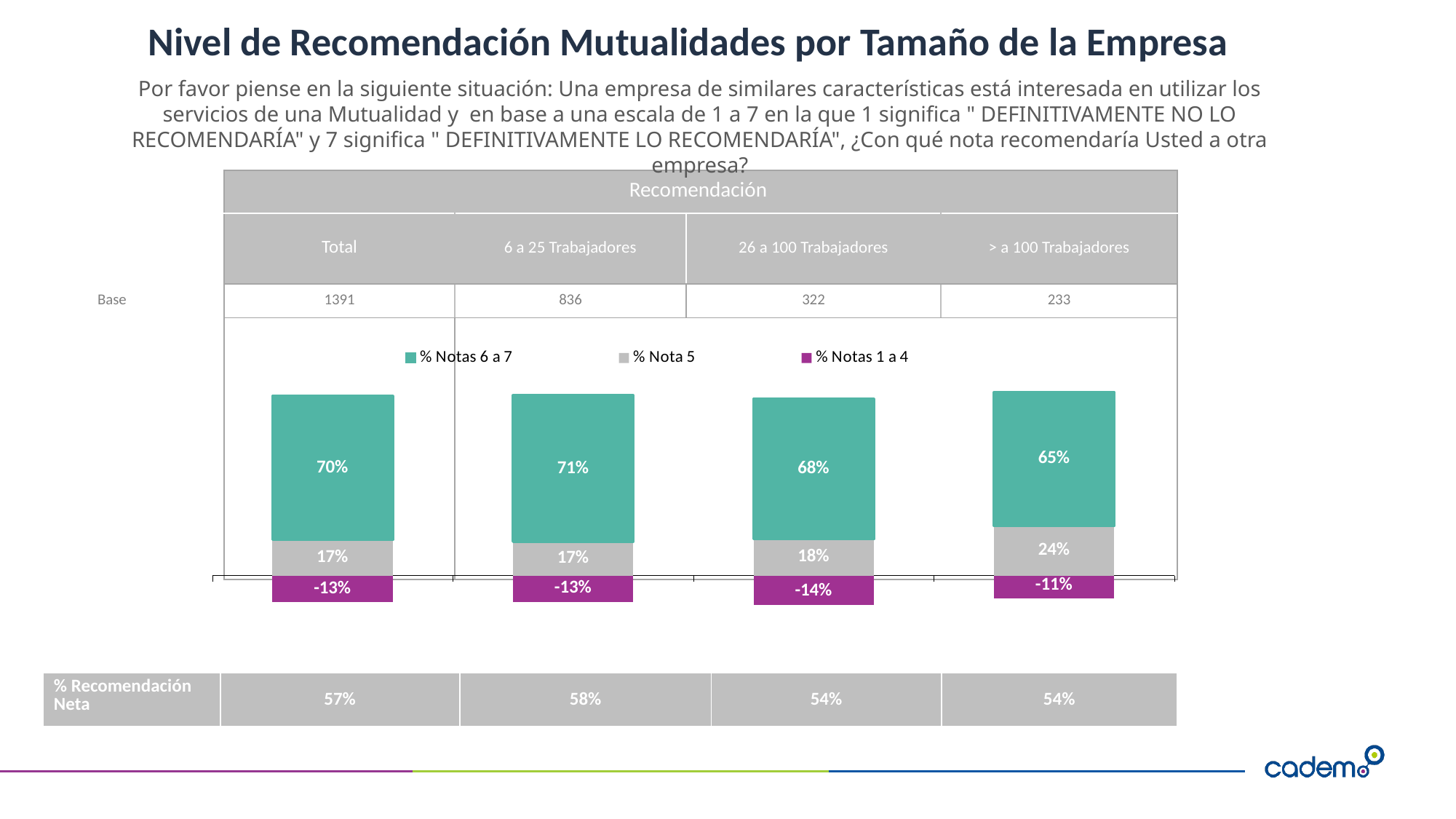
What is the value of % Notas 1 a 4 for the 26 a 100 Trabajadores category? -14% What is the value of % Notas 6 a 7 for the Total category? 70% What kind of chart is shown on the slide? Stacked bar chart What is the difference between the % Notas 6 a 7 values for 6 a 25 Trabajadores and > a 100 Trabajadores? 6 percentage points What is the value of % Nota 5 for the > a 100 Trabajadores category? 24% Which series is shown in purple in the chart legend? % Notas 1 a 4 Which category has the highest value for % Notas 6 a 7? 6 a 25 Trabajadores Which is larger: the % Nota 5 value for 26 a 100 Trabajadores or for > a 100 Trabajadores? > a 100 Trabajadores How many series does the chart legend list? 3 What is the value of % Notas 6 a 7 for the 6 a 25 Trabajadores category? 71% Which category has the lowest value for % Notas 6 a 7? > a 100 Trabajadores How many categories are shown on the x axis of the chart? 4